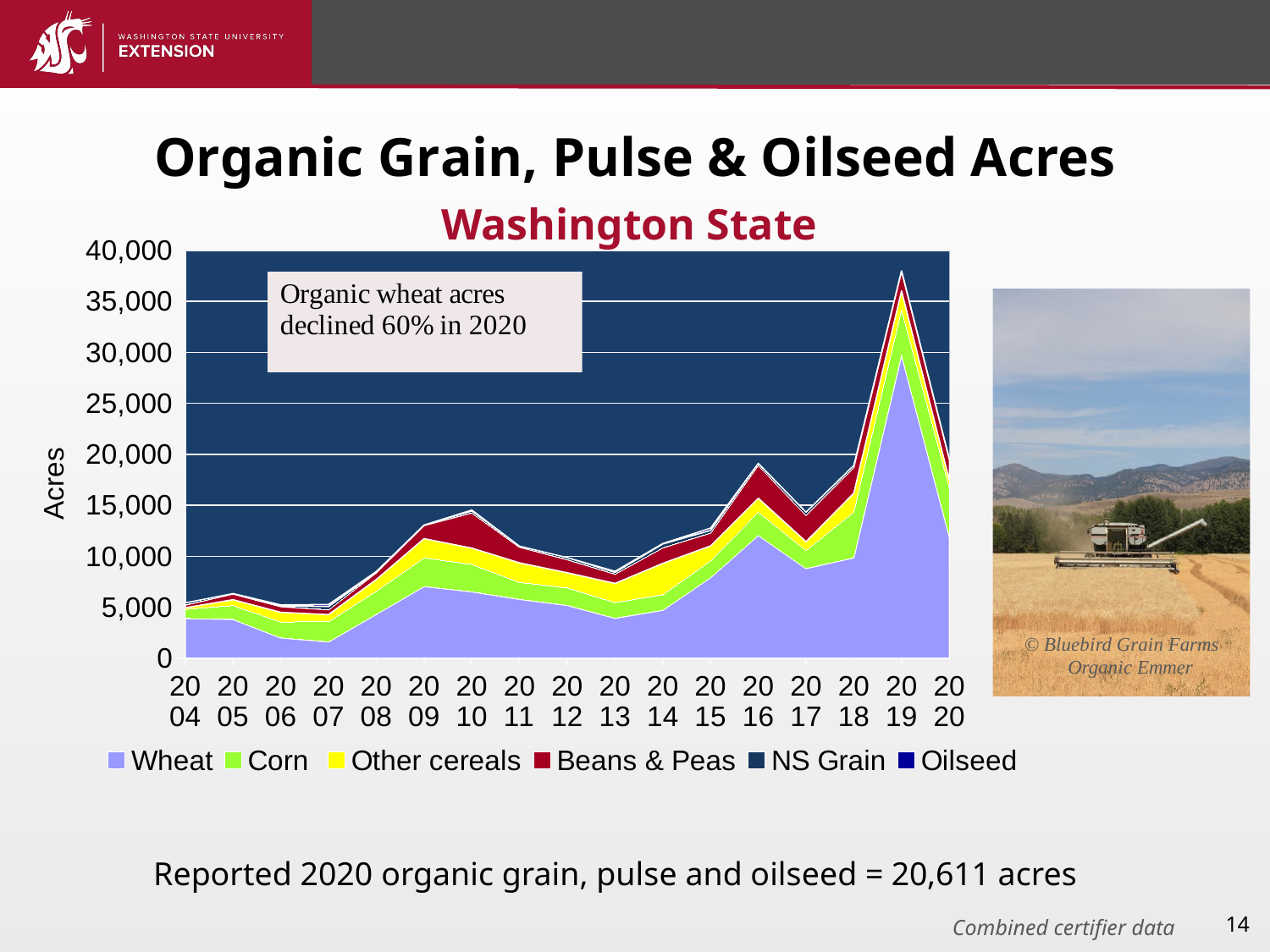
Is the total acreage in 2013 greater or less than 10,000? less Which year has the larger total acreage, 2016 or 2017? 2016 Is the total acreage in 2019 greater or less than 35,000? greater Which year has the larger total acreage, 2019 or 2020? 2019 How many years are shown along the x axis of the chart? 17 In which year does the total organic grain, pulse and oilseed acreage reach its highest point? 2019 How many series does the chart legend list? 6 Is the total acreage in 2016 greater or less than 20,000? less What kind of chart is shown on the slide? Stacked area chart According to the text on the slide, what was the reported 2020 organic grain, pulse and oilseed acreage? 20,611 acres What is the label on the y axis of the chart? Acres Does the total acreage rise or fall from 2017 to 2019? rise